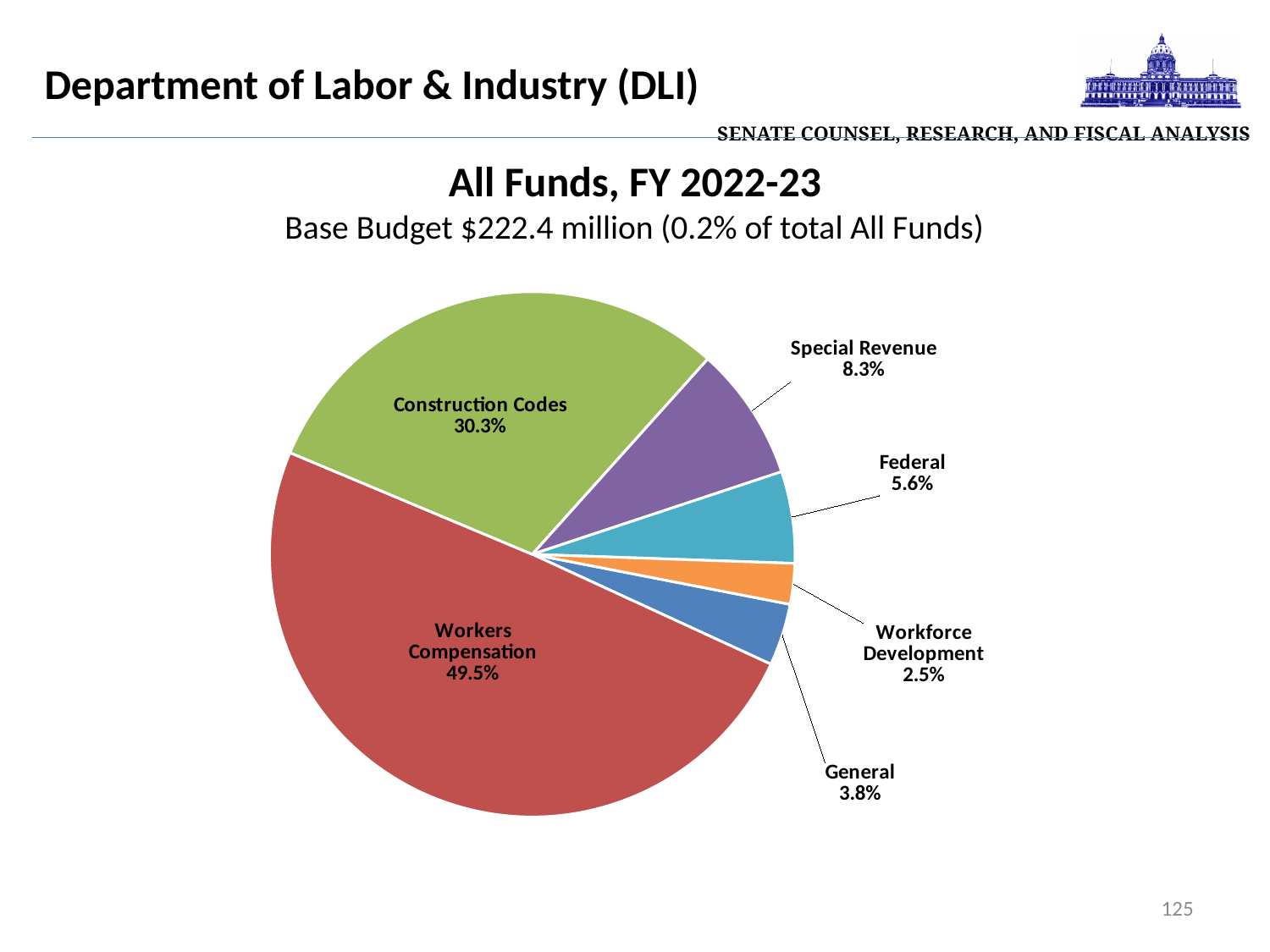
Which category has the smallest slice of the pie? Workforce Development What percentage is shown for Workforce Development? 2.5% What share of the pie does Workers Compensation represent? 49.5% How many categories are shown in the pie chart? 6 What is the title of the chart? All Funds, FY 2022-23 What is the value shown for Construction Codes? 30.3% What type of chart is shown on the slide? Pie chart What is the value shown for Federal? 5.6% What percentage is labeled for Special Revenue? 8.3% Which is larger, the Federal slice or the General slice? Federal What is the difference in percentage points between Workers Compensation and Construction Codes? 19.2 Which category has the largest slice of the pie? Workers Compensation